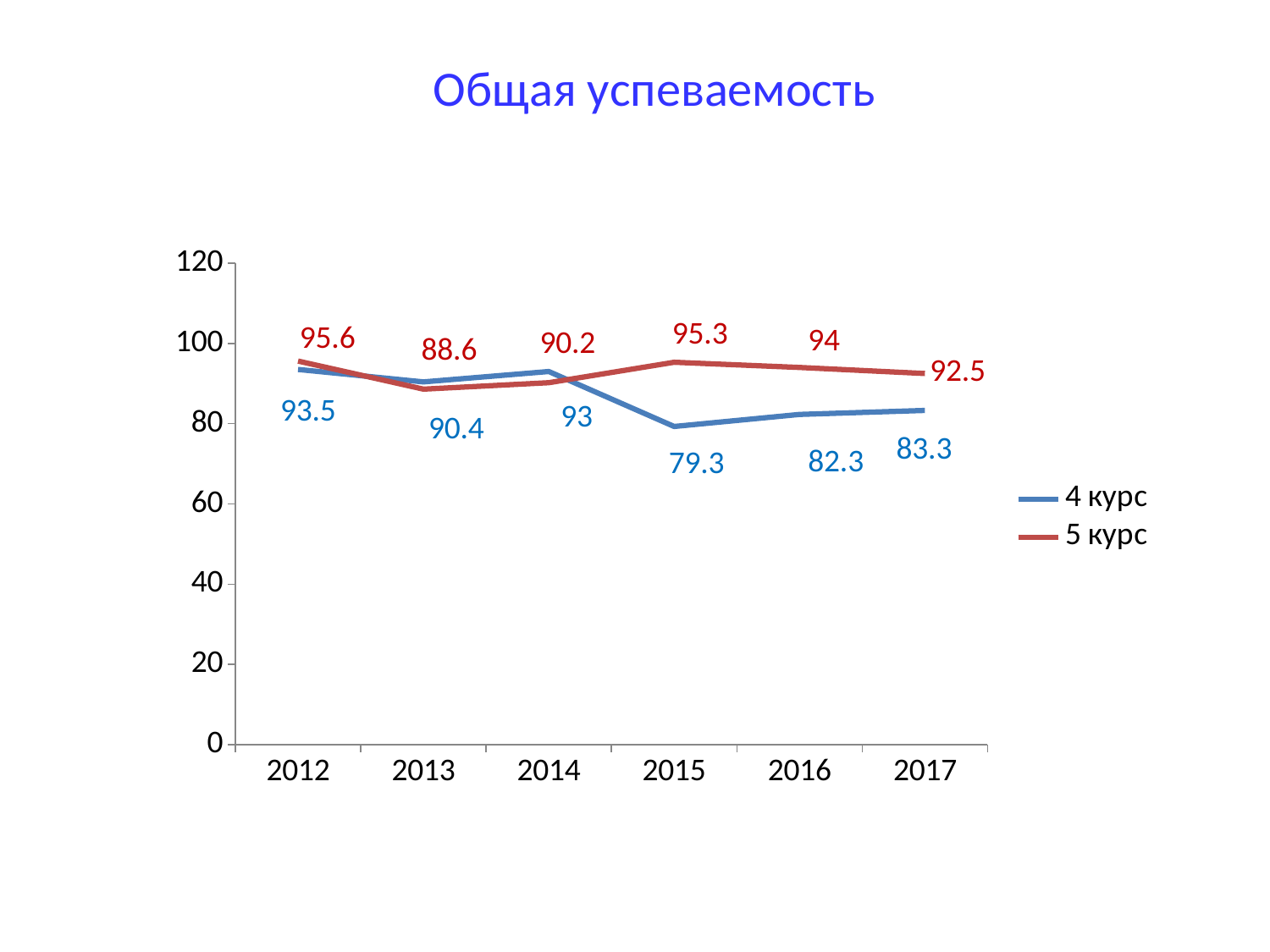
What is the value for 4 курс in 2015? 79.3 What is the difference between the 5 курс and 4 курс values in 2015? 16 What is the value for 5 курс in 2012? 95.6 Does the value for 4 курс rise or fall from 2014 to 2015? fall How many years are shown on the x axis? 6 How many series does the legend list? 2 What is the title of the chart? Общая успеваемость Which is larger in 2013: the value for 4 курс or for 5 курс? 4 курс What kind of chart is shown on the slide? line chart What is the value for 5 курс in 2017? 92.5 In which year is the value for 5 курс highest? 2012 In which year is the value for 4 курс lowest? 2015